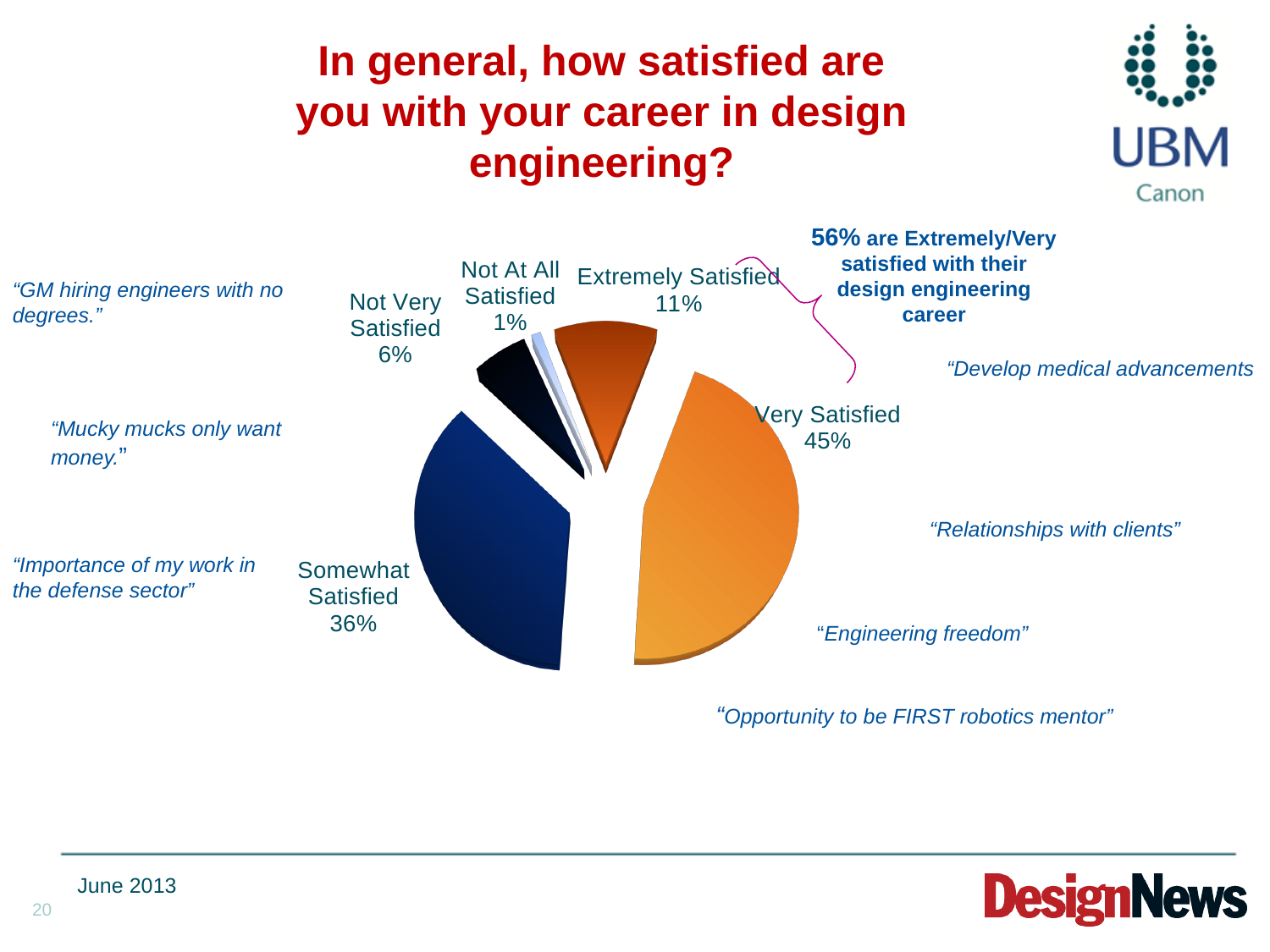
Which satisfaction level has the smallest share of the pie? Not At All Satisfied What is the difference in percentage points between Very Satisfied and Somewhat Satisfied? 9 How many slices does the pie chart have? 5 What kind of chart is shown on the slide? pie chart What percentage of respondents are Not At All Satisfied? 1% Which is larger, the share for Extremely Satisfied or the share for Not Very Satisfied? Extremely Satisfied What percentage of respondents are Not Very Satisfied? 6% What percentage of respondents are Extremely Satisfied? 11% What percentage of respondents are Very Satisfied with their career in design engineering? 45% Which satisfaction level has the largest share of the pie? Very Satisfied What percentage of respondents are Somewhat Satisfied? 36% What is the combined percentage of Extremely Satisfied and Very Satisfied respondents? 56%